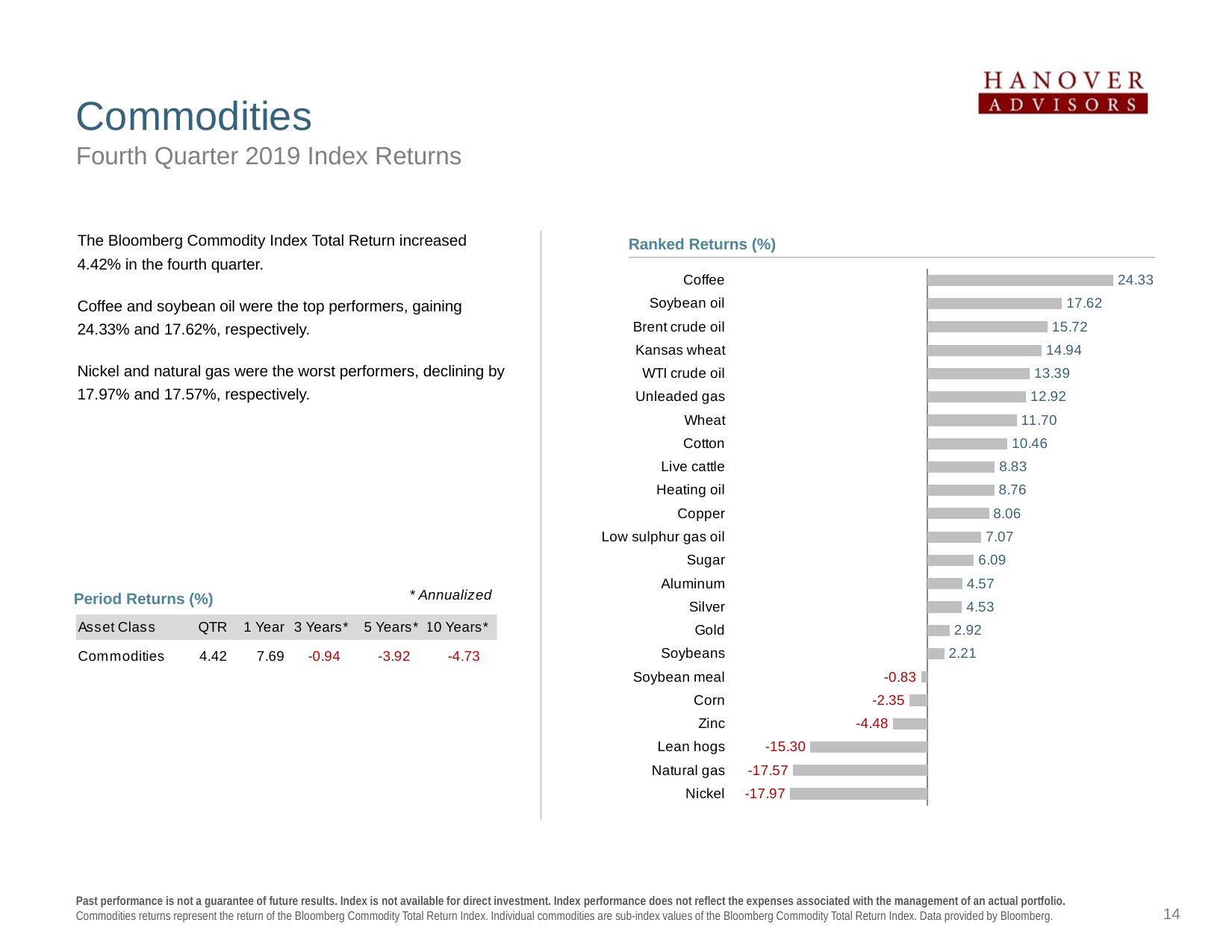
Which category has the highest value in the Ranked Returns (%) chart? Coffee What is the title of the chart on the slide? Ranked Returns (%) Which is larger in the Ranked Returns (%) chart, the value for Zinc or the value for Lean hogs? Zinc What kind of chart is the Ranked Returns (%) chart? Bar chart How many categories are shown in the Ranked Returns (%) chart? 23 What is the difference between the values for Gold and Soybeans in the Ranked Returns (%) chart? 0.71 Which category has the lowest value in the Ranked Returns (%) chart? Nickel What is the value for Natural gas in the Ranked Returns (%) chart? -17.57 Which is larger in the Ranked Returns (%) chart, the value for Wheat or the value for Cotton? Wheat What is the difference between the values for Coffee and Soybean oil in the Ranked Returns (%) chart? 6.71 What is the value for Copper in the Ranked Returns (%) chart? 8.06 What is the value for Coffee in the Ranked Returns (%) chart? 24.33